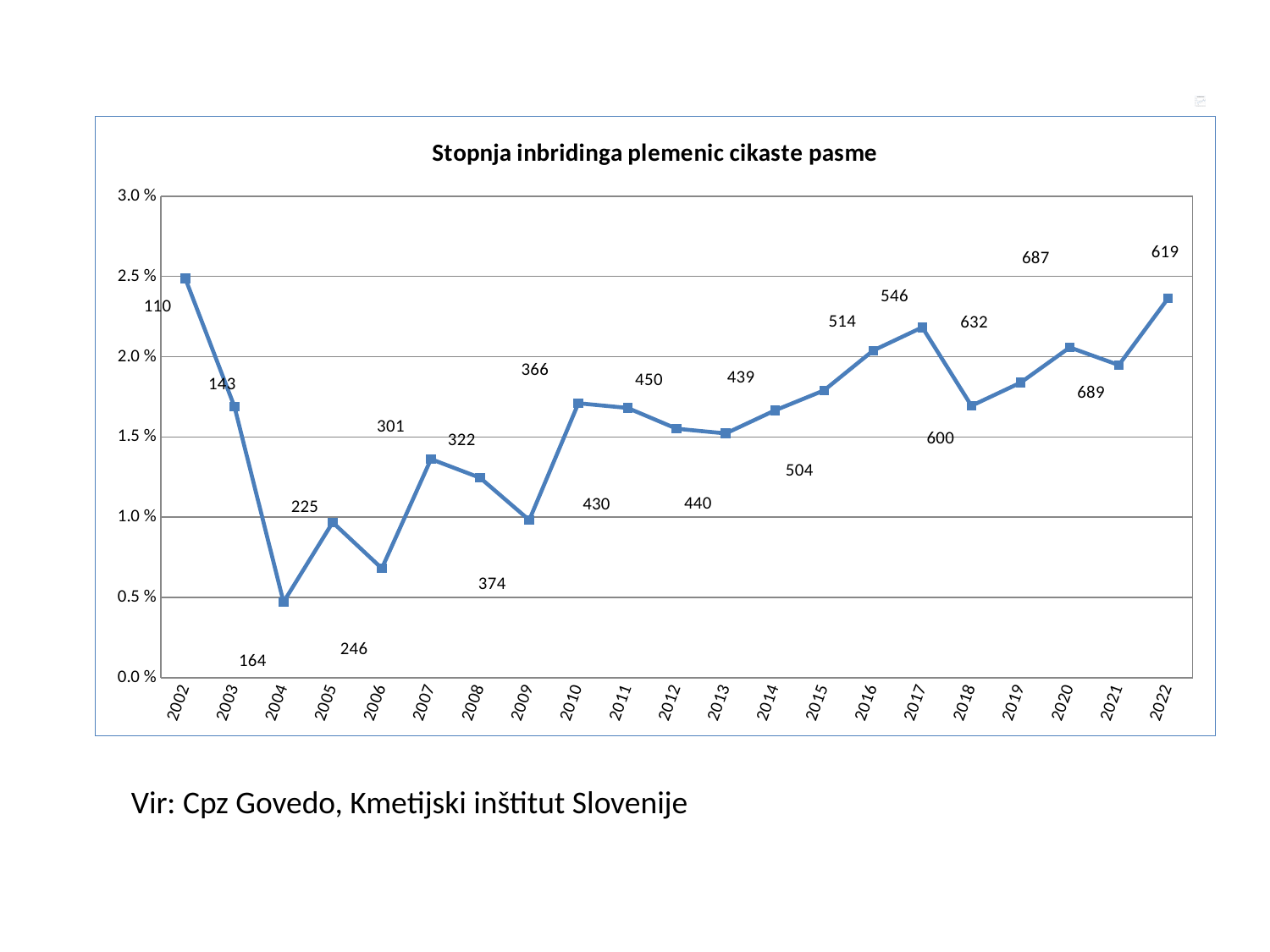
Is the value for 2018 greater or less than 2.0 %? less What is the title of the chart? Stopnja inbridinga plemenic cikaste pasme Do the values rise or fall from 2002 to 2004? fall Which year has the lowest value on the chart? 2004 How many years are plotted along the x axis of the chart? 21 Which year has the highest value on the chart? 2002 Is the value for 2002 greater or less than 2.0 %? greater Is the value for 2006 greater or less than 1.0 %? less Which year has the larger value, 2017 or 2018? 2017 What kind of chart is shown on the slide? line chart